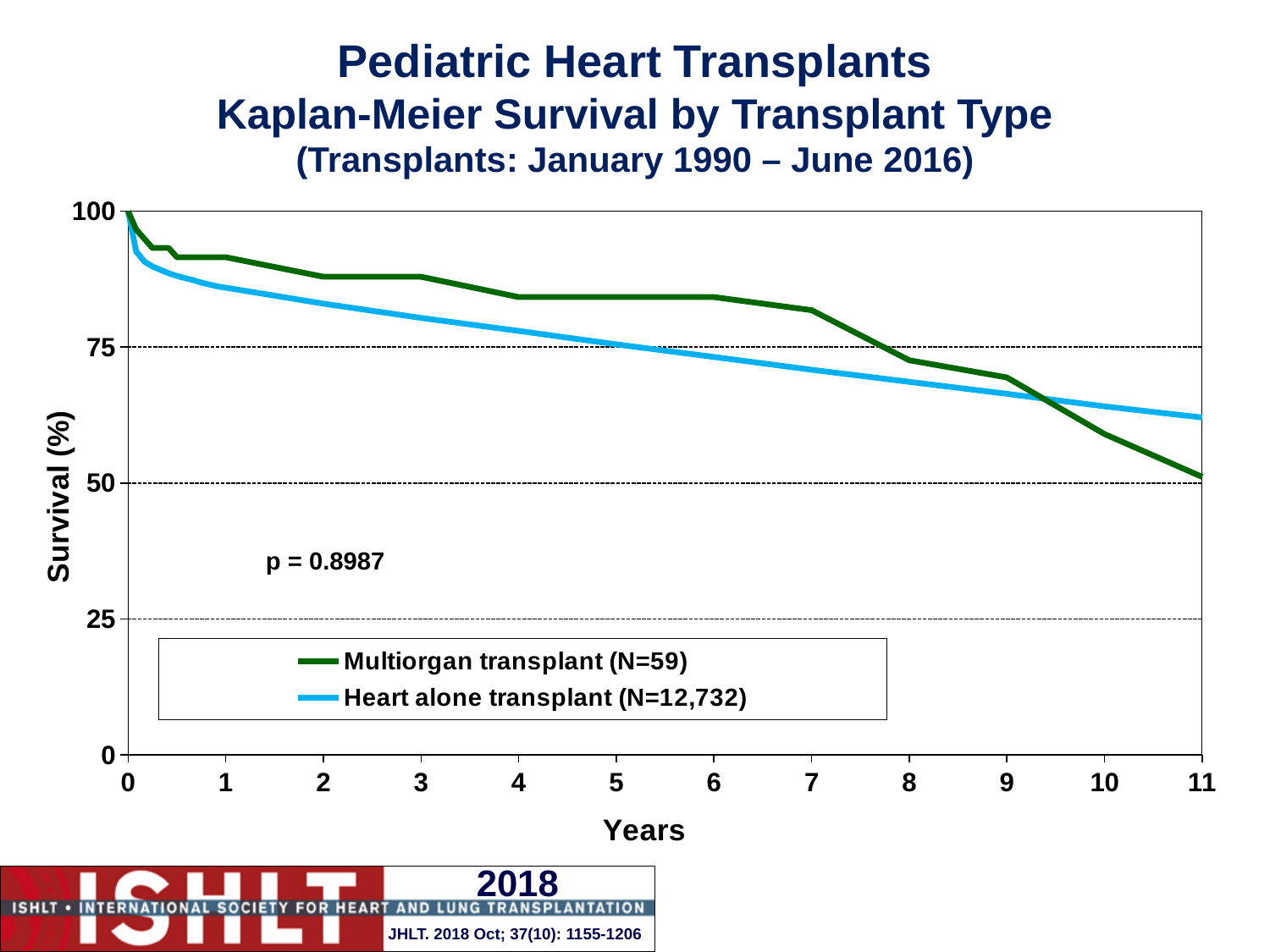
What is the p-value shown on the chart? p = 0.8987 At year 11, which series has the higher survival, Multiorgan transplant or Heart alone transplant? Heart alone transplant Is the survival value for Multiorgan transplant at year 11 greater or less than 75? less What kind of chart is shown on the slide? line chart At year 5, which series has the higher survival, Multiorgan transplant or Heart alone transplant? Multiorgan transplant Is the survival value for Multiorgan transplant at year 3 greater or less than 75? greater Does the survival for the Multiorgan transplant series rise or fall as years increase? fall What is the N for the Heart alone transplant series in the legend? N=12,732 Is the survival value for Heart alone transplant at year 11 greater or less than 50? greater How many series does the legend list? 2 Does the survival for the Heart alone transplant series rise or fall along the x axis? fall